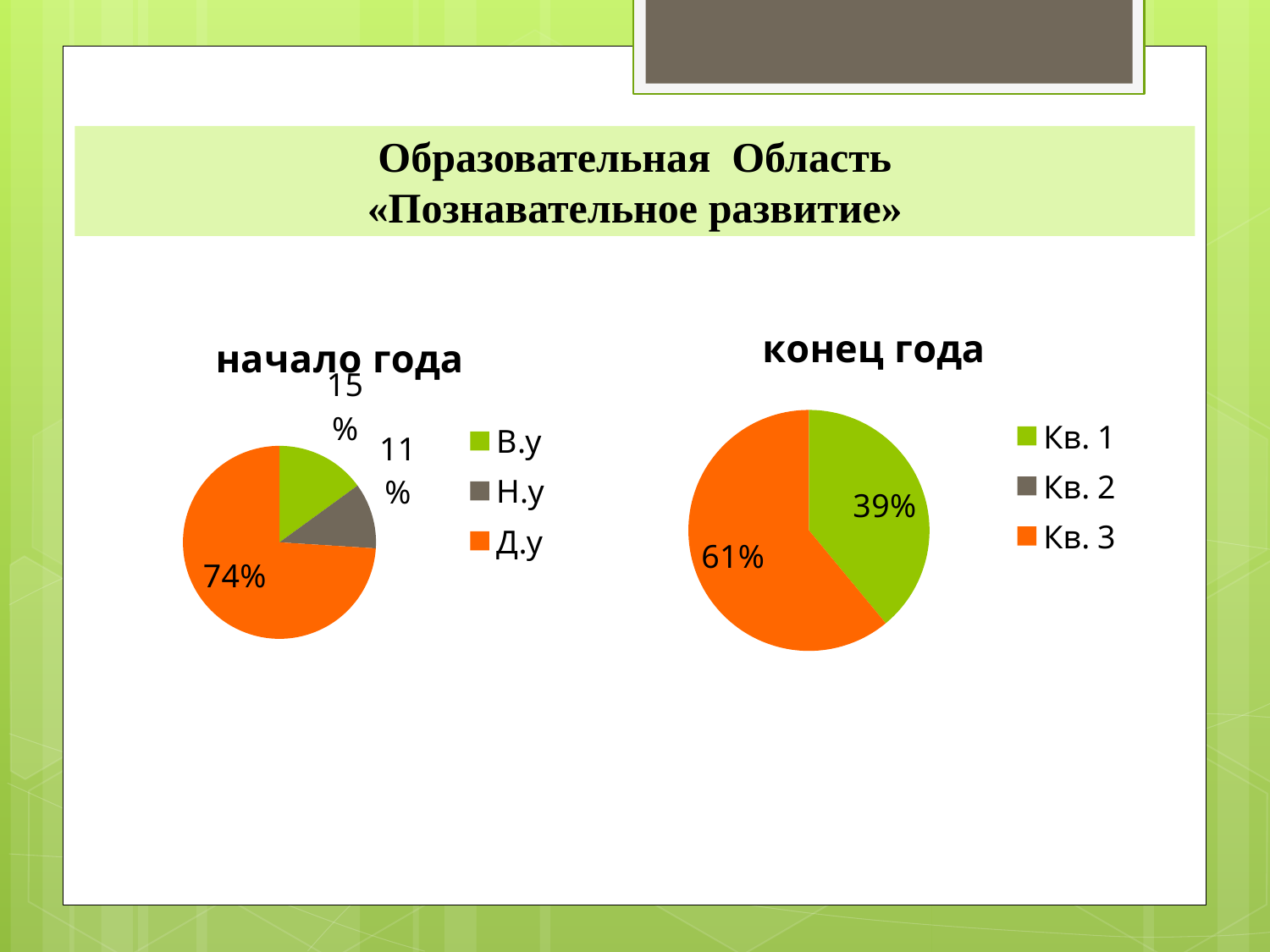
In the "начало года" chart, what is the value for В.у? 15% In the "конец года" chart, what is the value for Кв. 3? 61% In the "начало года" chart, what is the value for Н.у? 11% In the "начало года" chart, what is the difference between the Д.у and В.у shares? 59% In the "начало года" chart, which category has the smallest share? Н.у In the "начало года" chart, which category has the largest share? Д.у How many entries does the legend of the "конец года" chart list? 3 In the "начало года" chart, what is the value for Д.у? 74% In the "конец года" chart, what is the difference between the Кв. 3 and Кв. 1 shares? 22% In the "конец года" chart, what is the value for Кв. 1? 39% In the "конец года" chart, which is larger, Кв. 1 or Кв. 3? Кв. 3 What kind of chart is the "начало года" chart? pie chart